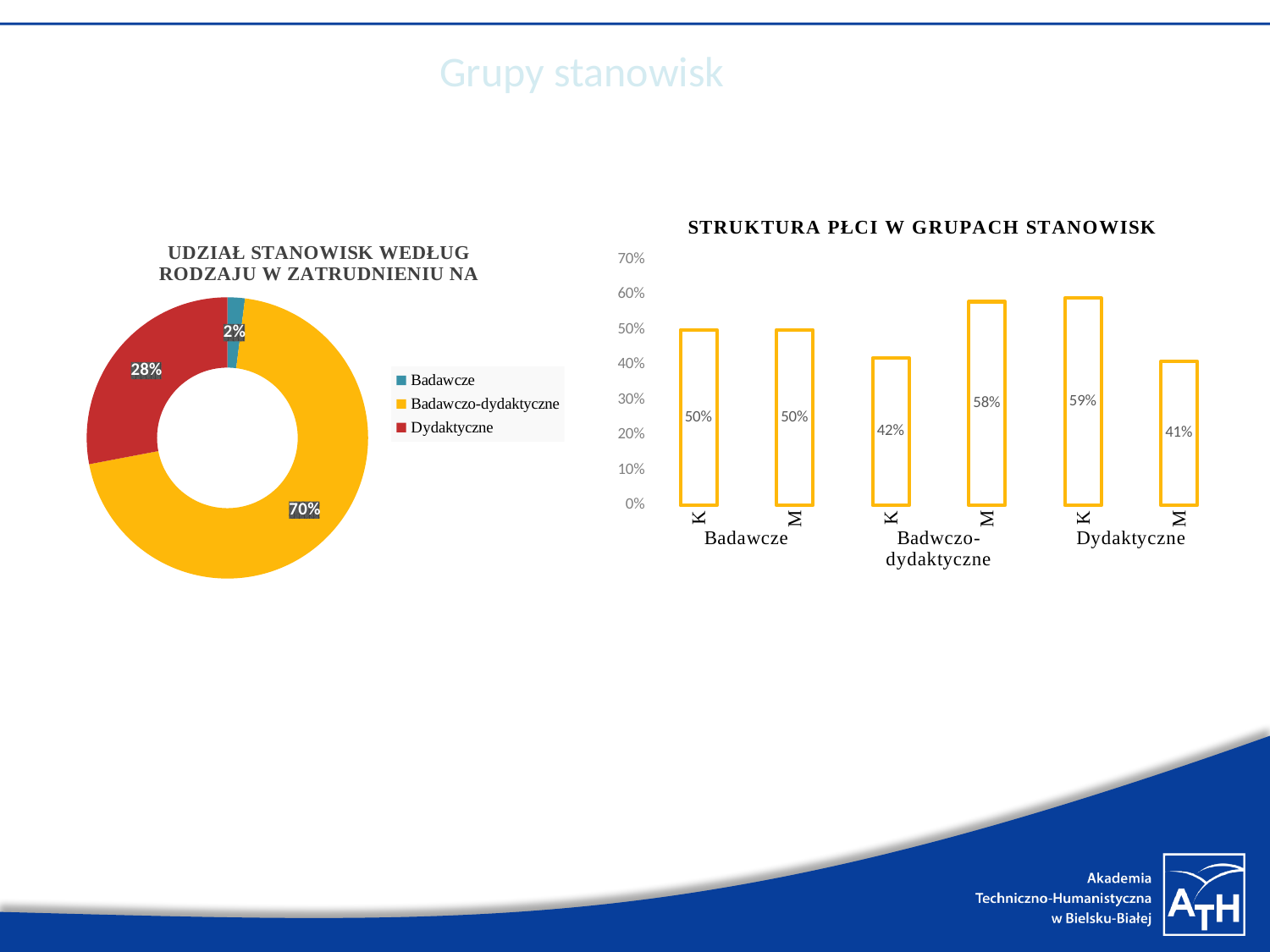
In the chart titled 'STRUKTURA PŁCI W GRUPACH STANOWISK', which bar is the highest? K in Dydaktyczne (59%) In the chart titled 'STRUKTURA PŁCI W GRUPACH STANOWISK', how many bars are plotted? 6 In the chart titled 'UDZIAŁ STANOWISK WEDŁUG RODZAJU W ZATRUDNIENIU NA', what share does Badawczo-dydaktyczne have? 70% In the chart titled 'STRUKTURA PŁCI W GRUPACH STANOWISK', what is the value for M in the Badawczo-dydaktyczne group? 58% What kind of chart is the one titled 'STRUKTURA PŁCI W GRUPACH STANOWISK'? Bar chart In the chart titled 'UDZIAŁ STANOWISK WEDŁUG RODZAJU W ZATRUDNIENIU NA', which category has the smallest share? Badawcze What kind of chart is the one on the left of the slide? Doughnut (pie) chart In the chart titled 'STRUKTURA PŁCI W GRUPACH STANOWISK', what is the difference between K and M in the Dydaktyczne group? 18% In the chart titled 'UDZIAŁ STANOWISK WEDŁUG RODZAJU W ZATRUDNIENIU NA', how many categories does the legend list? 3 In the chart titled 'UDZIAŁ STANOWISK WEDŁUG RODZAJU W ZATRUDNIENIU NA', what share does Dydaktyczne have? 28% In the chart titled 'STRUKTURA PŁCI W GRUPACH STANOWISK', which is larger: K or M in the Badawczo-dydaktyczne group? M In the chart titled 'STRUKTURA PŁCI W GRUPACH STANOWISK', what is the value for K in the Dydaktyczne group? 59%